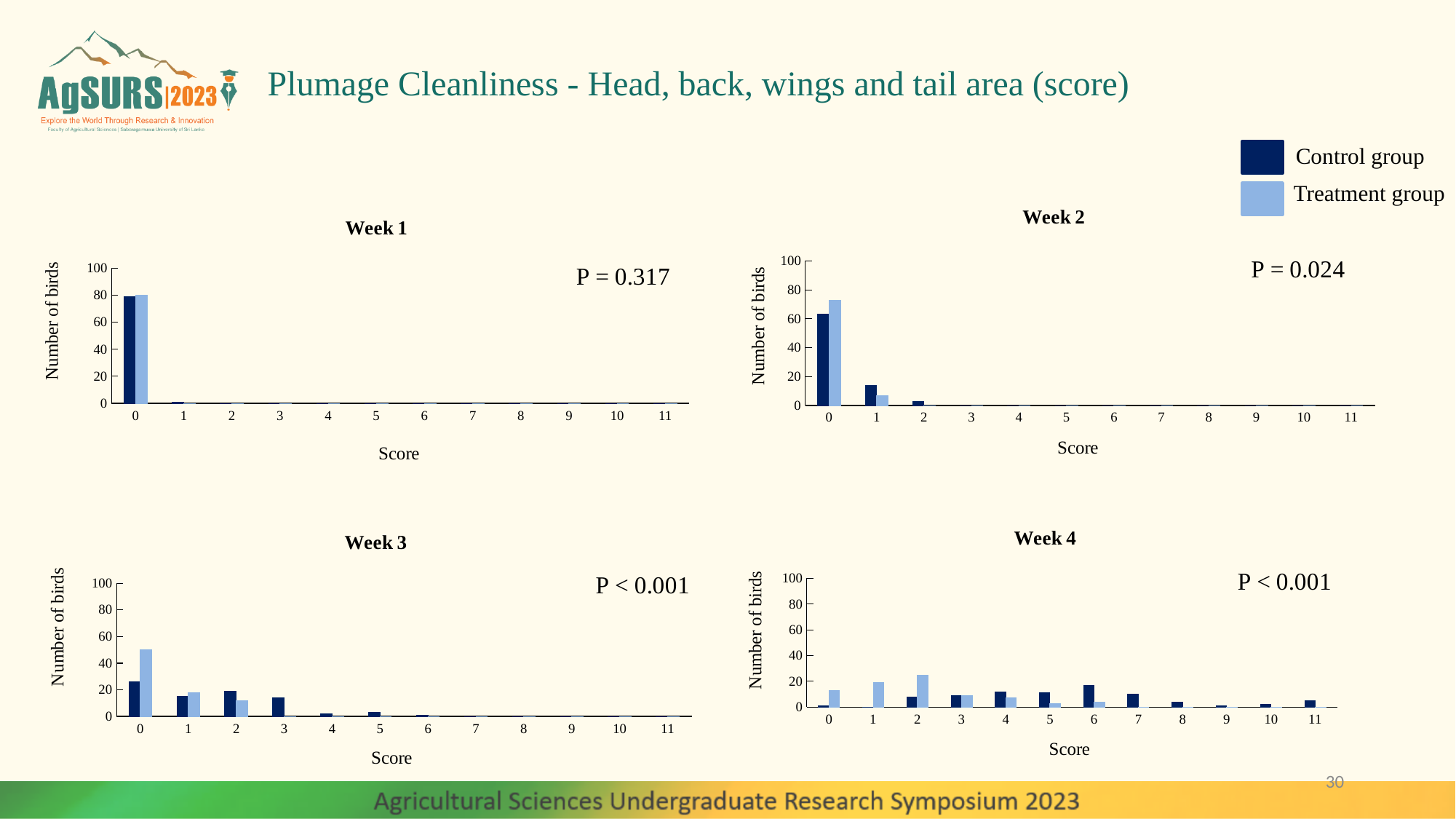
What P value is shown on the Week 2 chart? P = 0.024 In the Week 4 chart, is the value for the Treatment group at score 2 greater or less than 40? less What kind of chart is the Week 1 chart? bar chart In the Week 2 chart, which group has the larger value at score 1, Control group or Treatment group? Control group In the Week 3 chart, at which score does the Treatment group have its highest value? 0 How many series does the legend list? 2 In the Week 4 chart, which group has the larger value at score 6, Control group or Treatment group? Control group In the Week 1 chart, is the value for the Treatment group at score 0 greater or less than 60? greater In the Week 2 chart, is the value for the Control group at score 0 greater or less than 40? greater In the Week 3 chart, which group has the larger value at score 0, Control group or Treatment group? Treatment group How many score categories are shown on the x axis of the Week 3 chart? 12